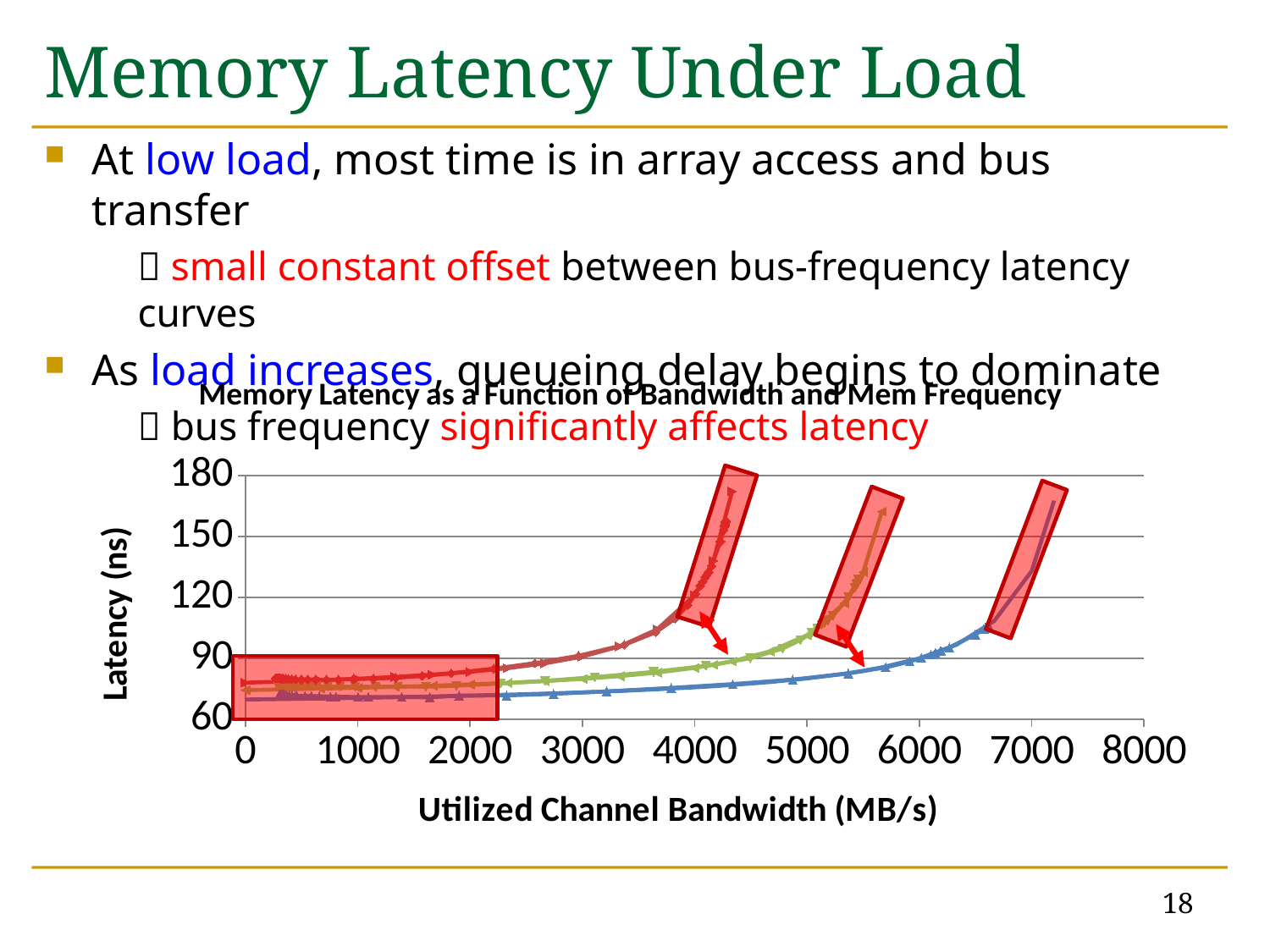
At 3000 MB/s, which curve has the higher latency, the red curve or the blue curve? red curve Which curve reaches its steep rise in latency at the highest bandwidth? blue curve Is the latency of the green curve at 4000 MB/s greater or less than 90 ns? less What is the label of the x axis of the chart? Utilized Channel Bandwidth (MB/s) Is the latency of the red curve at 2000 MB/s greater or less than 90 ns? less As utilized channel bandwidth increases along the x axis, does latency rise or fall? rise Which curve reaches its steep rise in latency at the lowest bandwidth? red curve Is the latency of the blue curve at 5000 MB/s greater or less than 90 ns? less What is the title of the chart? Memory Latency as a Function of Bandwidth and Mem Frequency What kind of chart is shown on the slide? line chart